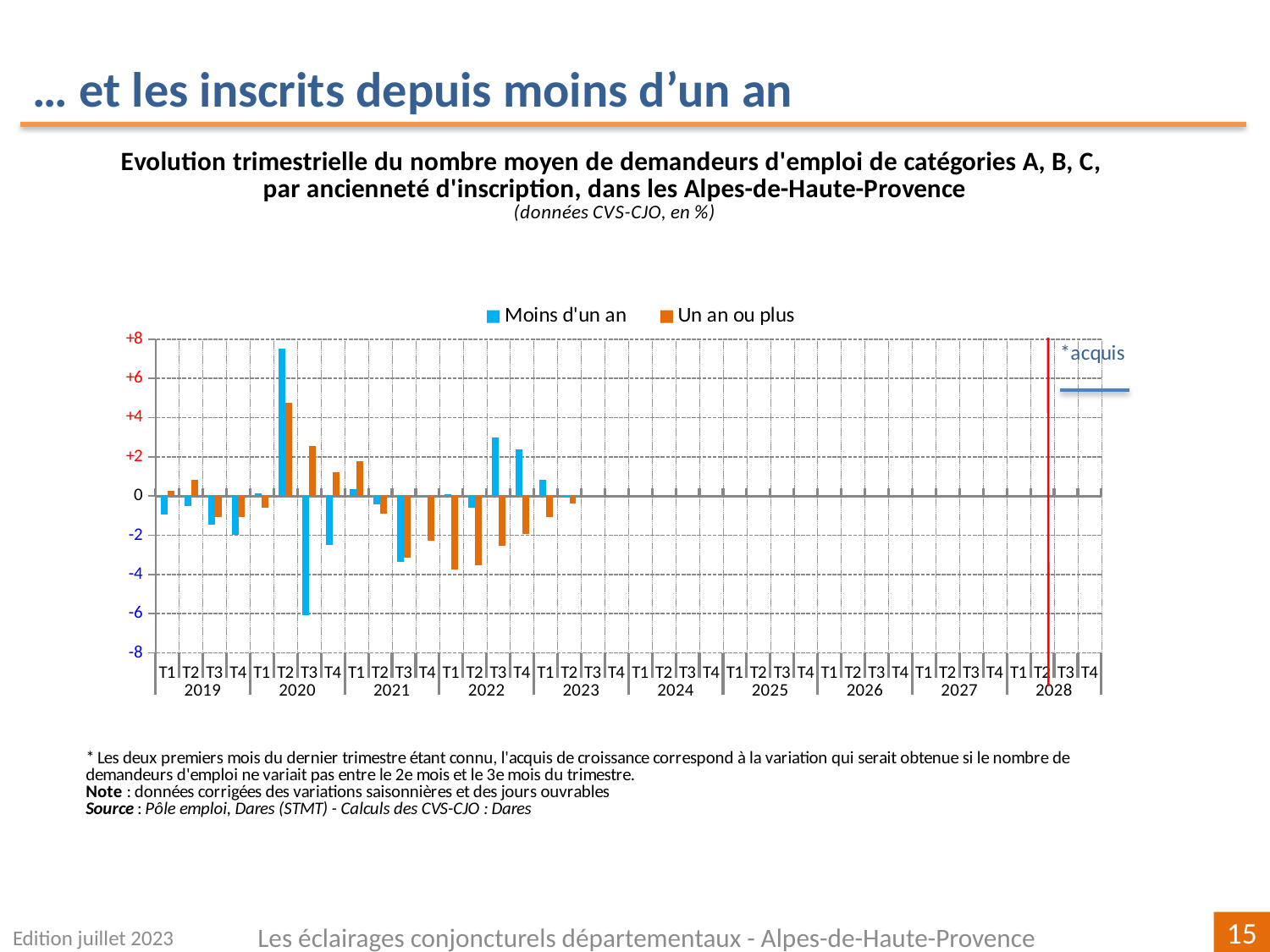
What kind of chart is shown on the slide? bar chart Is the value for 'Moins d'un an' in T2 2020 greater or less than +6? greater Does the 'Moins d'un an' series rise or fall from T3 2022 to T1 2023? fall What are the two series named in the chart legend? Moins d'un an; Un an ou plus In which quarter does the 'Moins d'un an' series reach its highest value? T2 2020 How many series does the chart legend list? 2 In which quarter does the 'Moins d'un an' series reach its lowest value? T3 2020 Is the value for 'Un an ou plus' in T3 2021 greater or less than -2? less Is the value for 'Moins d'un an' in T3 2020 greater or less than -4? less In T2 2020, which series has the larger value, 'Moins d'un an' or 'Un an ou plus'? Moins d'un an In which quarter does the 'Un an ou plus' series reach its highest value? T2 2020 How many years are labelled along the x axis of the chart? 10